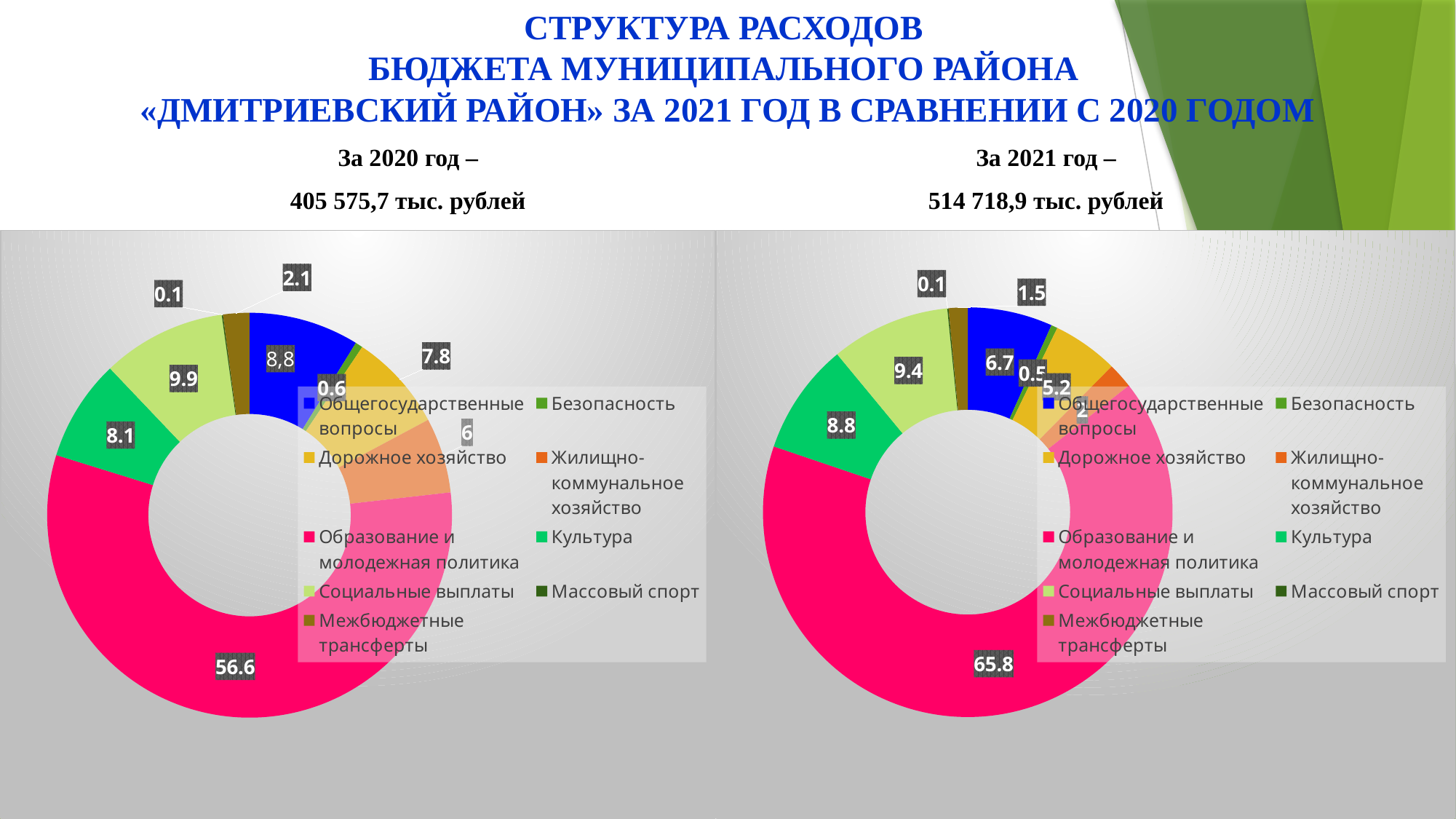
What type of chart is used for the 2021 data on the right? Doughnut chart In the left chart (За 2020 год), what is the difference between the values for Социальные выплаты and Культура? 1.8 How many categories does the legend of the left chart (За 2020 год) list? 9 In the right chart (За 2021 год), what is the value for Дорожное хозяйство? 5.2 In the right chart (За 2021 год), what is the value for Образование и молодежная политика? 65.8 In the right chart (За 2021 год), which category has the smallest share? Массовый спорт What total expenditure amount is shown above the right chart for 2021? 514 718,9 тыс. рублей In the left chart (За 2020 год), what is the value for Образование и молодежная политика? 56.6 In the right chart (За 2021 год), which is larger: Культура or Общегосударственные вопросы? Культура In the left chart (За 2020 год), which category has the largest share? Образование и молодежная политика In the left chart (За 2020 год), what is the value for Общегосударственные вопросы? 8,8 In the right chart (За 2021 год), what is the value for Социальные выплаты? 9.4